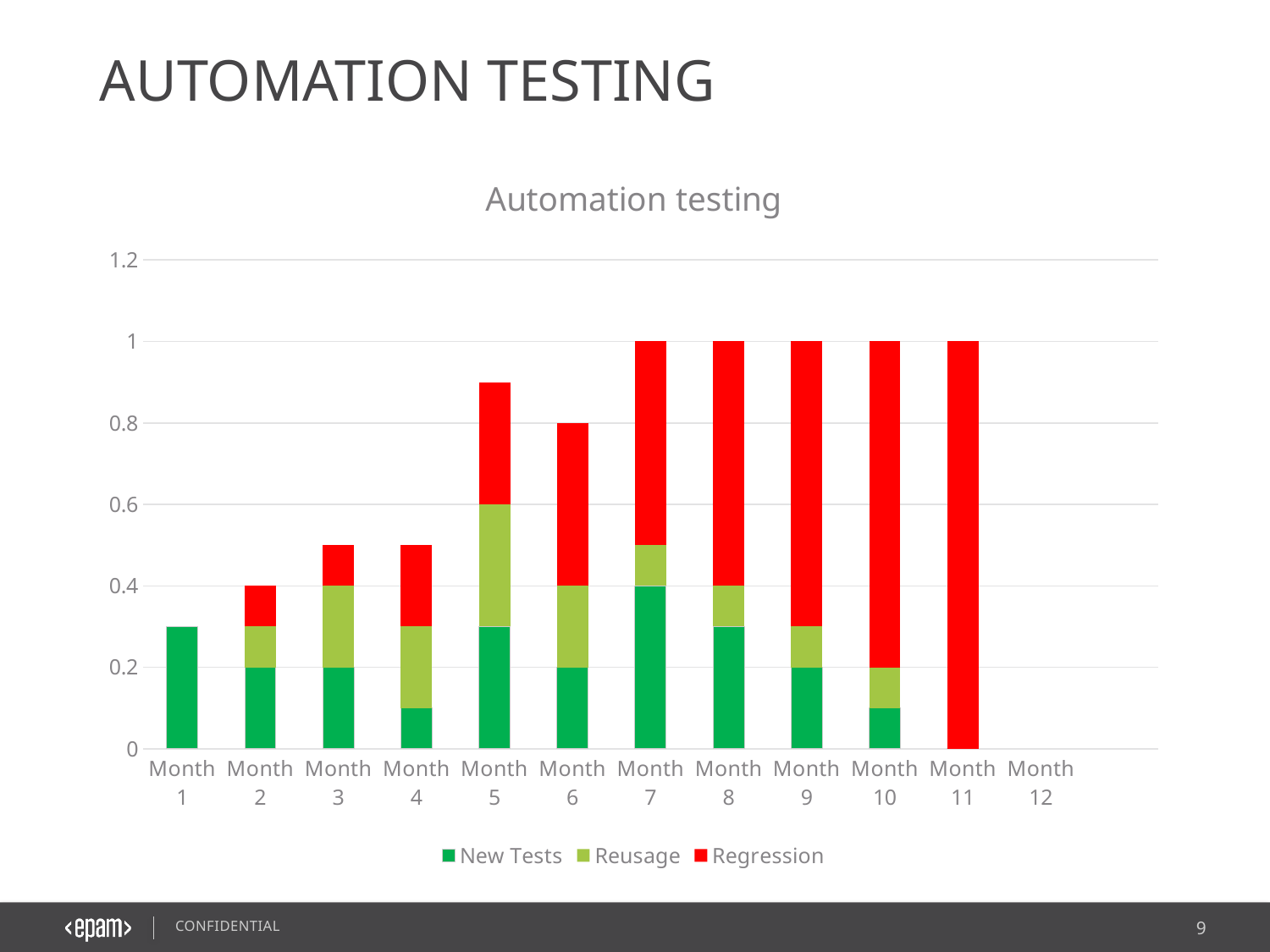
Do the bar totals rise or fall from Month 1 to Month 7? rise Which series is shown in red? Regression What is the total height of the stacked bar for Month 2? 0.4 How many series does the legend list? 3 Which has the larger total, Month 4 or Month 5? Month 5 Is the total for Month 5 greater or less than 0.8? greater Is the total for Month 1 greater or less than 0.4? less What is the value of New Tests for Month 7? 0.4 How many month categories are shown on the x axis? 12 What is the total height of the stacked bar for Month 6? 0.8 What kind of chart is shown on the slide? Stacked bar chart What is the total height of the stacked bar for Month 11? 1